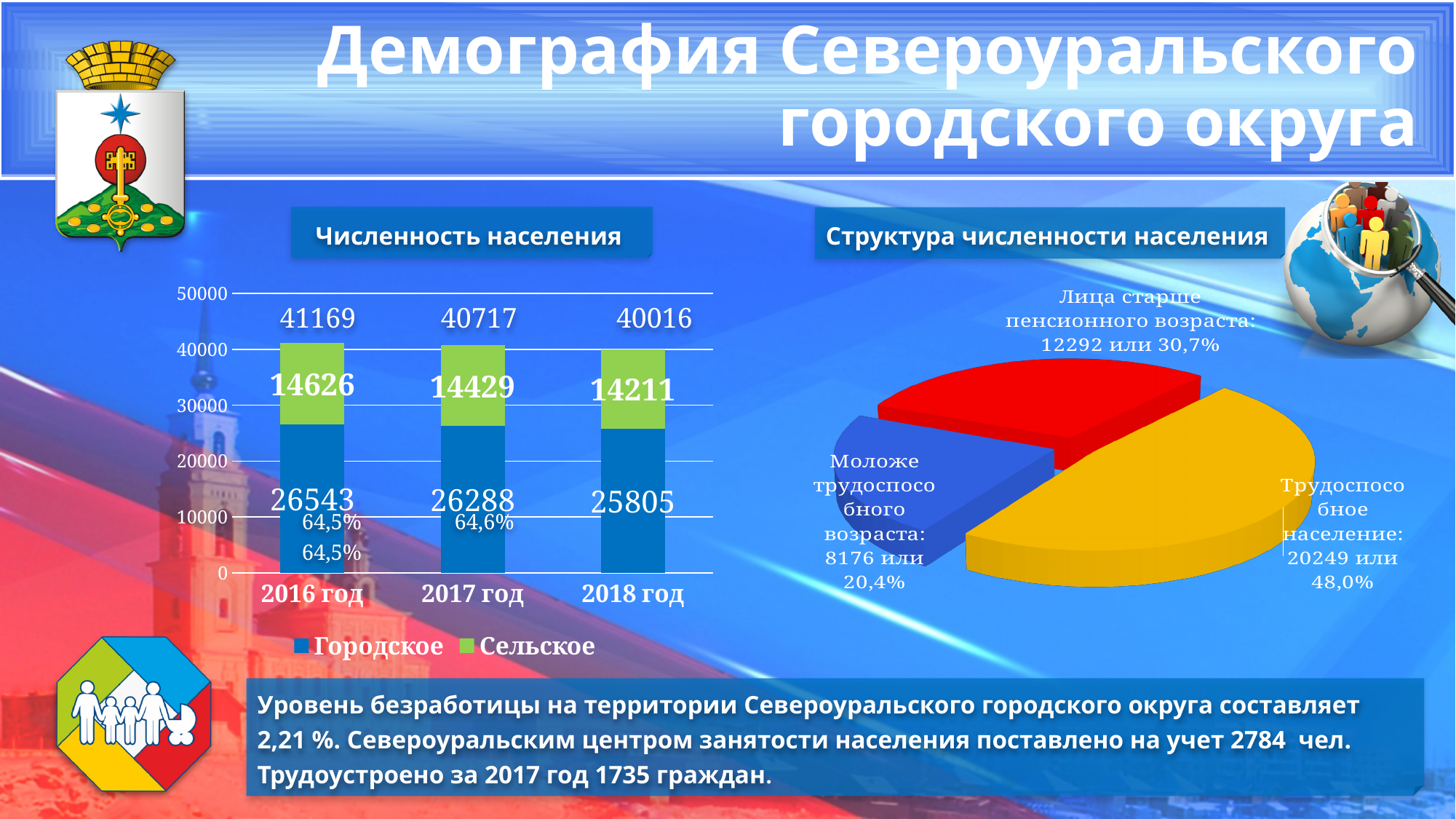
In the 'Численность населения' chart, does the Сельское value rise or fall from 2016 год to 2018 год? fall In the 'Численность населения' chart, what is the value for Сельское in 2018 год? 14211 In the 'Структура численности населения' chart, which slice is the smallest? Моложе трудоспособного возраста In the 'Численность населения' chart, which year has the lowest total population? 2018 год In the 'Численность населения' chart, what is the difference between the Городское values for 2016 год and 2018 год? 738 In the 'Структура численности населения' chart, what share of the pie is Трудоспособное население? 48,0% In the 'Структура численности населения' chart, what is the value for Лица старше пенсионного возраста? 12292 In the 'Численность населения' chart, what is the value for Городское in 2016 год? 26543 In the 'Численность населения' chart, what is the total of the stacked bar for 2017 год? 40717 What kind of chart is 'Численность населения'? stacked bar chart In the 'Структура численности населения' chart, how many slices does the pie have? 3 In the 'Численность населения' chart, how many series does the legend list? 2